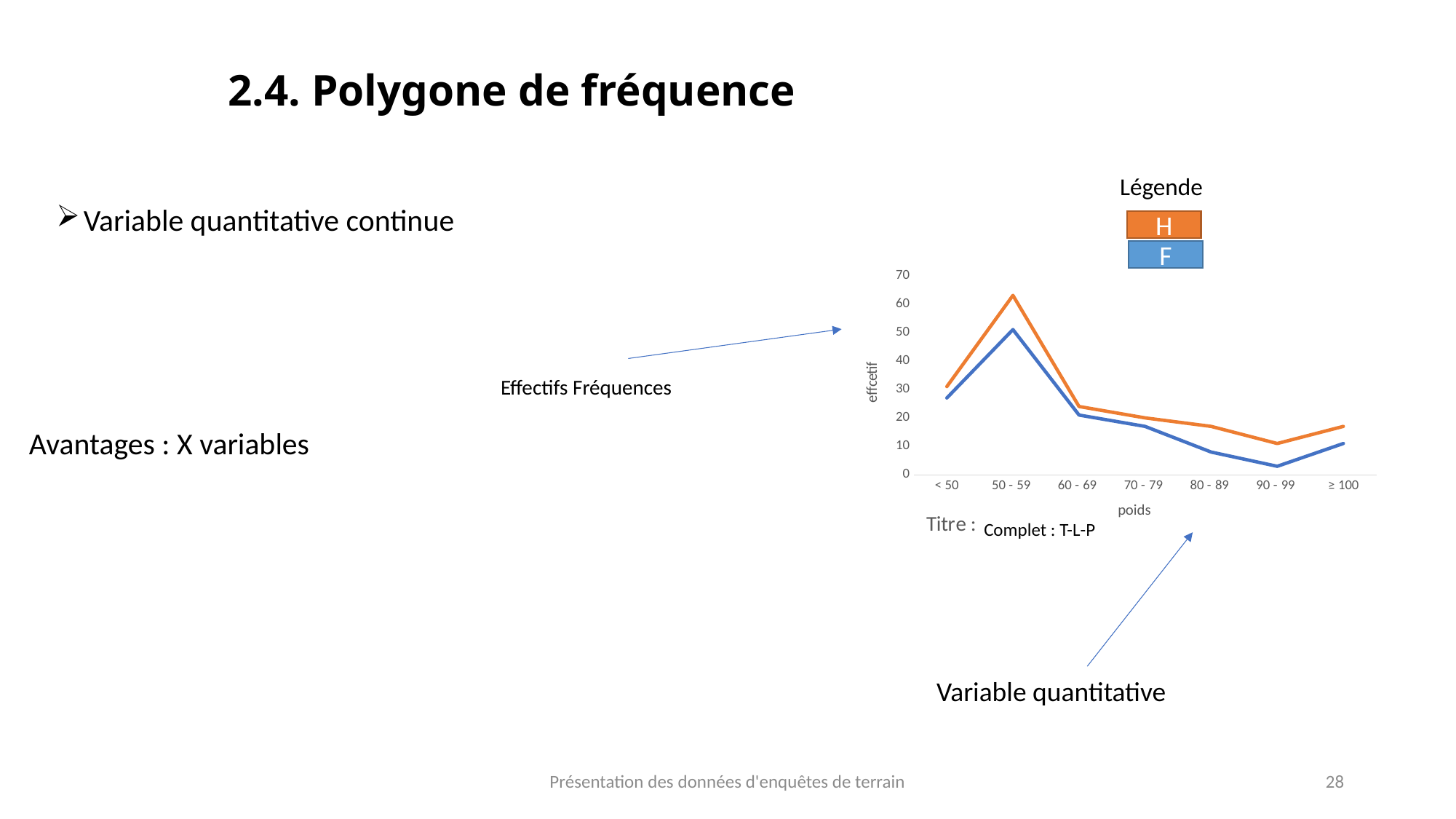
What kind of chart is shown on the slide? line chart Does the H series rise or fall from 50 - 59 to 90 - 99? fall At the 50 - 59 category, which series has the larger value, H or F? H For which weight category is the H series lowest? 90 - 99 How many categories are shown on the x axis of the chart? 7 For which weight category is the F series highest? 50 - 59 How many series does the legend list? 2 For which weight category is the H series highest? 50 - 59 What is the label of the x axis of the chart? poids For which weight category is the F series lowest? 90 - 99 Is the value of the H series for 50 - 59 greater or less than 50? greater Is the value of the F series for 90 - 99 greater or less than 10? less